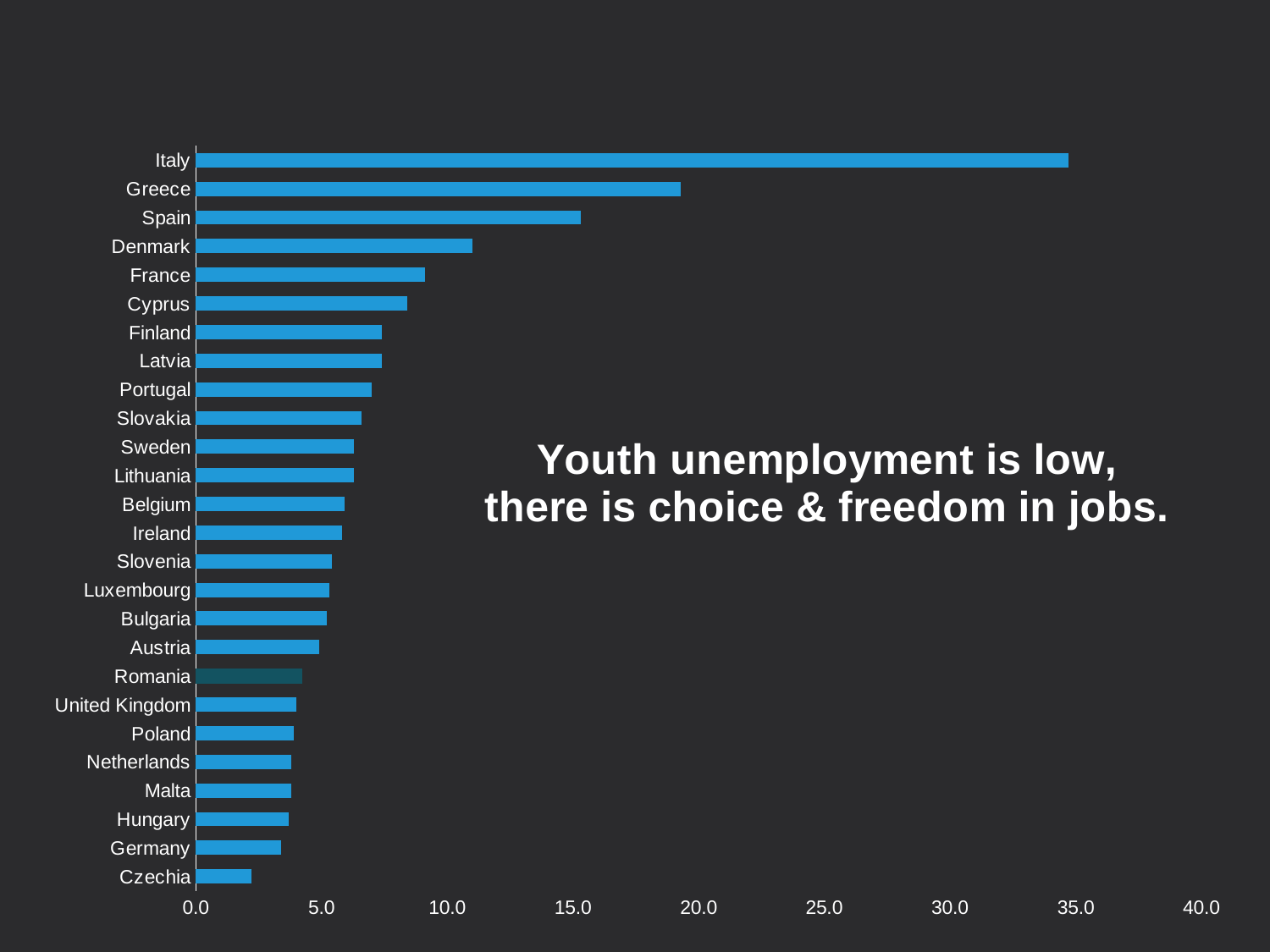
Which country has the highest value in the chart? Italy What kind of chart is shown on the slide? bar chart How many countries are plotted in the chart? 26 Is the value for Greece greater or less than 15.0? greater Which country's bar is shown in a different colour from the rest? Romania Is the value for France greater or less than 10.0? less Which has the larger value, Greece or Spain? Greece Is the value for Italy greater or less than 30.0? greater Which country has the lowest value in the chart? Czechia Do the bar values increase or decrease going from the top of the chart (Italy) to the bottom (Czechia)? decrease